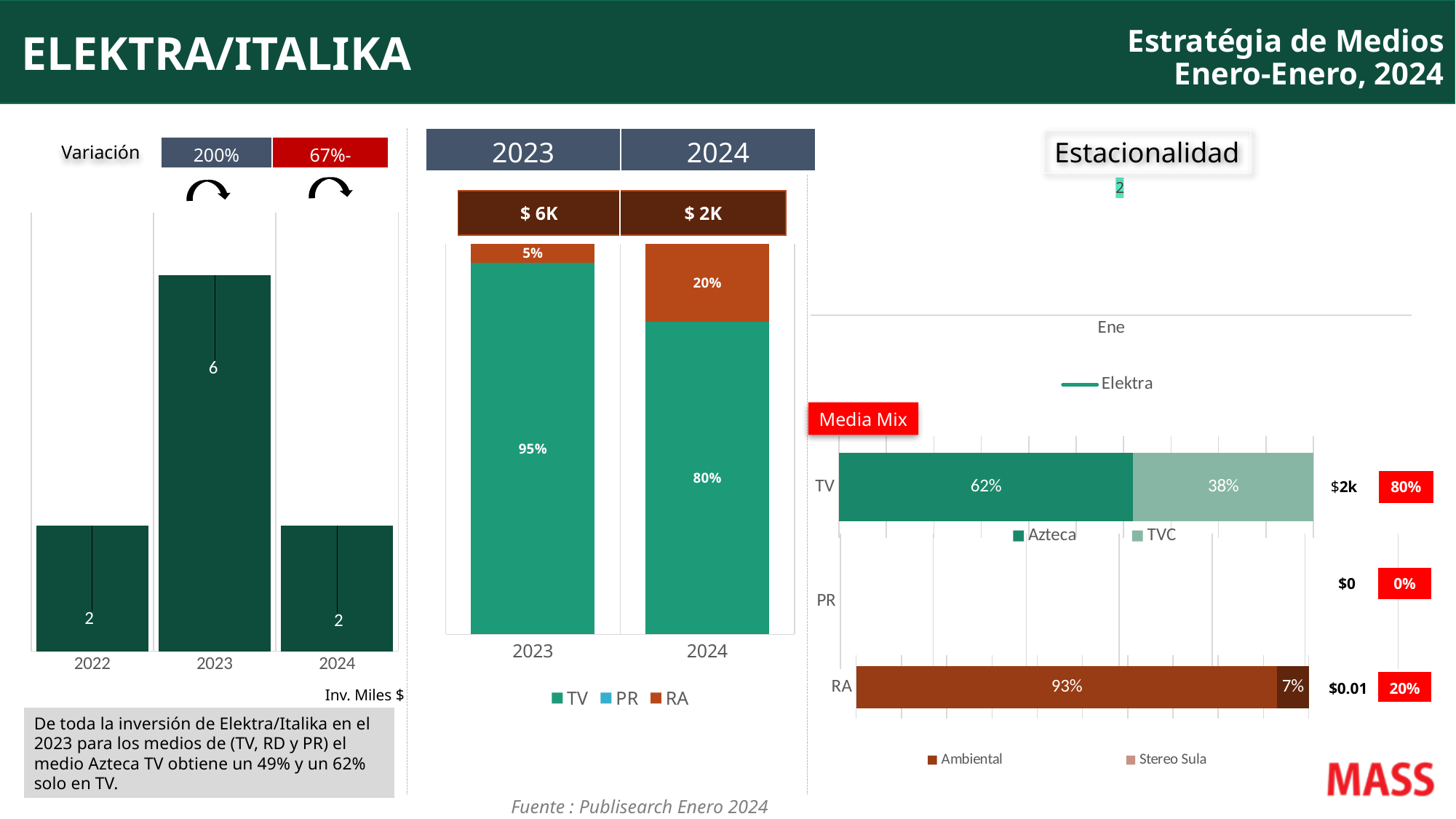
In the Media Mix chart, what is the difference between the Ambiental and Stereo Sula percentages within RA? 86% In the middle stacked bar chart comparing 2023 and 2024, what share does RA have in 2023? 5% In the Media Mix chart, what percentage does Azteca have within TV? 62% In the Media Mix chart, what percentage does Stereo Sula have within RA? 7% In the left bar chart of investment by year, how many years are shown? 3 In the middle stacked bar chart comparing 2023 and 2024, how many series does the legend list? 3 In the middle stacked bar chart comparing 2023 and 2024, what share does TV have in 2024? 80% In the left bar chart of investment by year, what is the difference between the 2023 and 2024 values? 4 In the middle stacked bar chart comparing 2023 and 2024, is the TV share larger in 2023 or in 2024? 2023 In the left bar chart of investment by year, what is the value for 2023? 6 In the left bar chart of investment by year, which year has the highest value? 2023 What kind of chart is the left chart of investment by year? bar chart